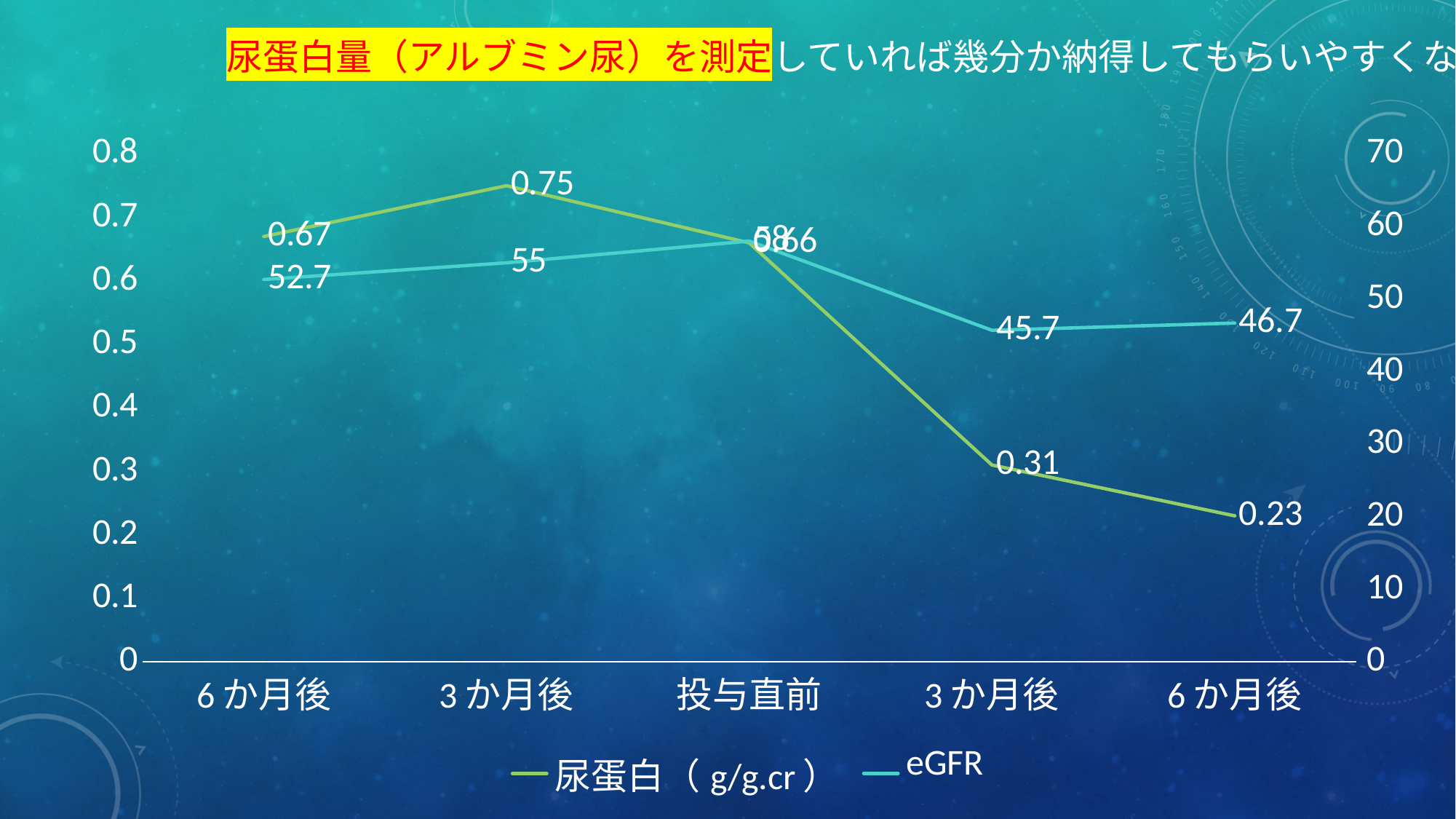
Which is larger: the eGFR value at the leftmost 6か月後 or at the following 3か月後 (before 投与直前)? 3か月後 (55) What is the difference between the highest 尿蛋白 value (0.75) and the lowest (0.23)? 0.52 How many series does the legend list? 2 What is the lowest 尿蛋白 value plotted? 0.23 How many time points are plotted along the x axis? 5 What is the 尿蛋白 value at the rightmost point (6か月後, after 投与直前)? 0.23 What is the 尿蛋白 value at the second point from the left (3か月後, before 投与直前)? 0.75 What kind of chart is shown on the slide? line chart At which time point is the 尿蛋白 value highest? 3か月後 (before 投与直前) Does the 尿蛋白 line rise or fall from 投与直前 to the rightmost 6か月後? fall What is the eGFR value at the fourth point from the left (3か月後, after 投与直前)? 45.7 What is the eGFR value at the leftmost point (6か月後, before 投与直前)? 52.7